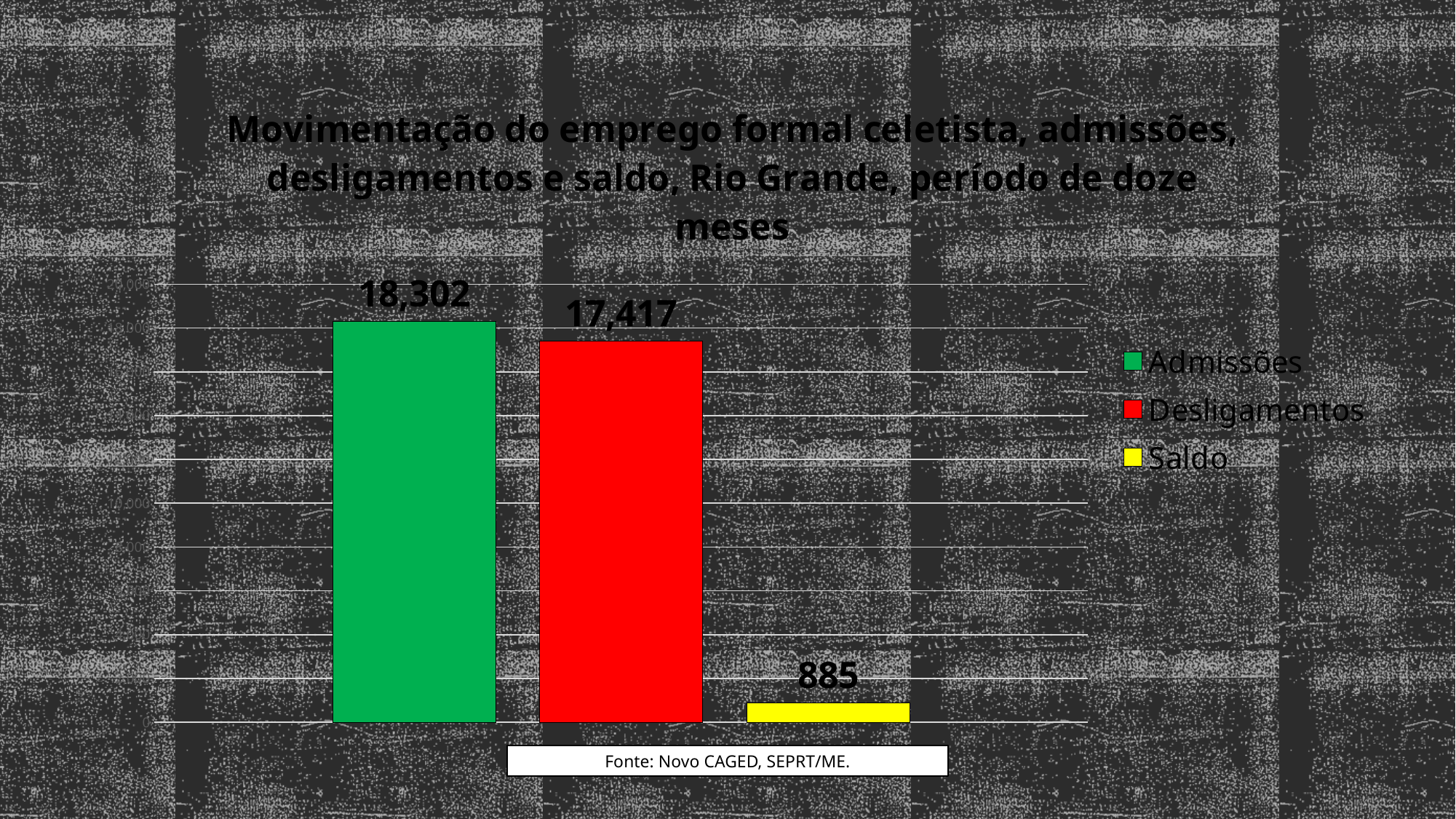
What is the difference between Admissões and Desligamentos? 885 How many series does the legend list? 3 What kind of chart is shown on the slide? Bar chart What is the value for Admissões? 18,302 How many bars are plotted in the chart? 3 What colour is the Saldo bar? Yellow Which series has the lowest value? Saldo Which series has the highest value? Admissões Which is larger, Admissões or Desligamentos? Admissões What is the value for Saldo? 885 What is the value for Desligamentos? 17,417 What is the difference between Desligamentos and Saldo? 16,532